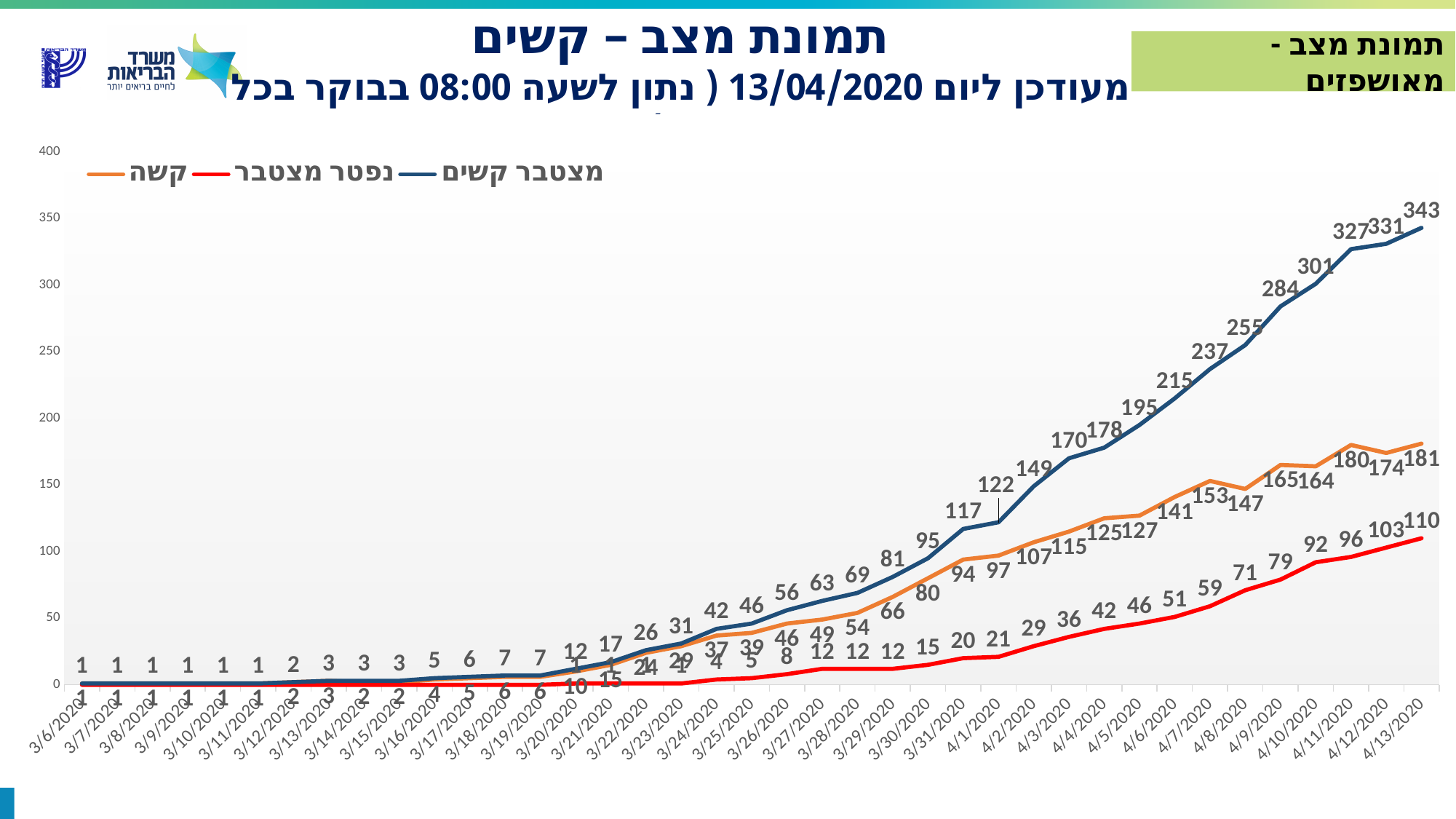
What kind of chart is shown on the slide? Line chart Does the מצטבר קשים series rise or fall over the dates shown? Rises What is the value of the מצטבר קשים series on 4/13/2020? 343 What is the value of the נפטר מצטבר series on 4/13/2020? 110 What is the value of the נפטר מצטבר series on 4/9/2020? 79 How many series does the legend list? 3 Is the value of the מצטבר קשים series on 4/10/2020 greater or less than 300? greater What is the value of the מצטבר קשים series on 3/31/2020? 117 What is the value of the קשה series on 4/13/2020? 181 What is the difference between the מצטבר קשים values on 4/13/2020 and 4/12/2020? 12 On which date does the מצטבר קשים series reach its highest value? 4/13/2020 Which series has the higher value on 4/13/2020, קשה or נפטר מצטבר? קשה